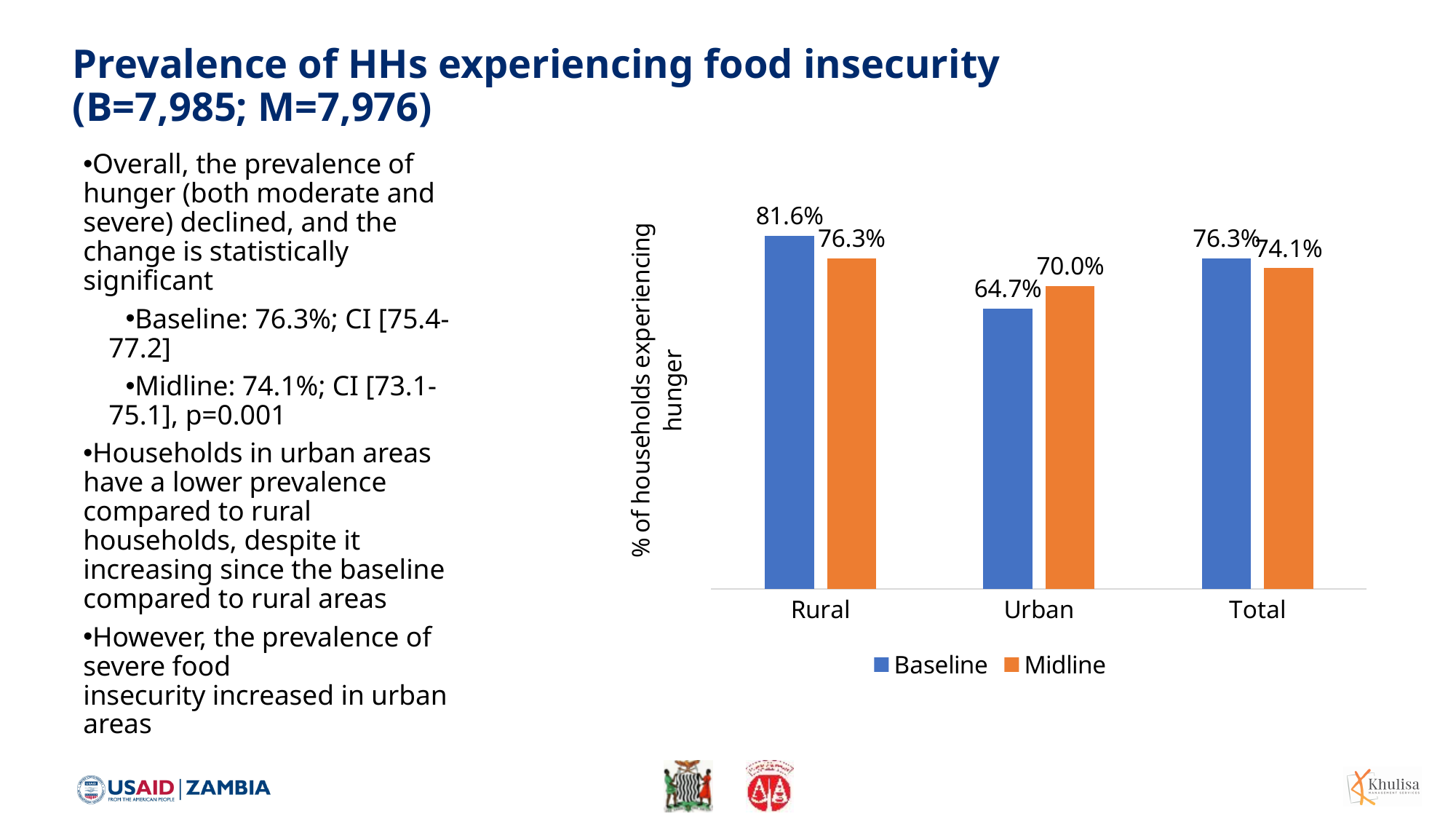
What kind of chart is shown on the slide? Bar chart How many categories are shown on the x axis? 3 Which is larger for Urban households, the Baseline value or the Midline value? Midline Which category has the highest Baseline value? Rural How many series does the legend list? 2 What is the difference between the Baseline and Midline values for Urban households? 5.3% What is the Baseline value for Rural households? 81.6% What is the Midline value for Urban households? 70.0% What is the label of the y axis? % of households experiencing hunger What is the Midline value for Total? 74.1% Which category has the lowest Midline value? Urban What is the difference between the Baseline and Midline values for Rural households? 5.3%